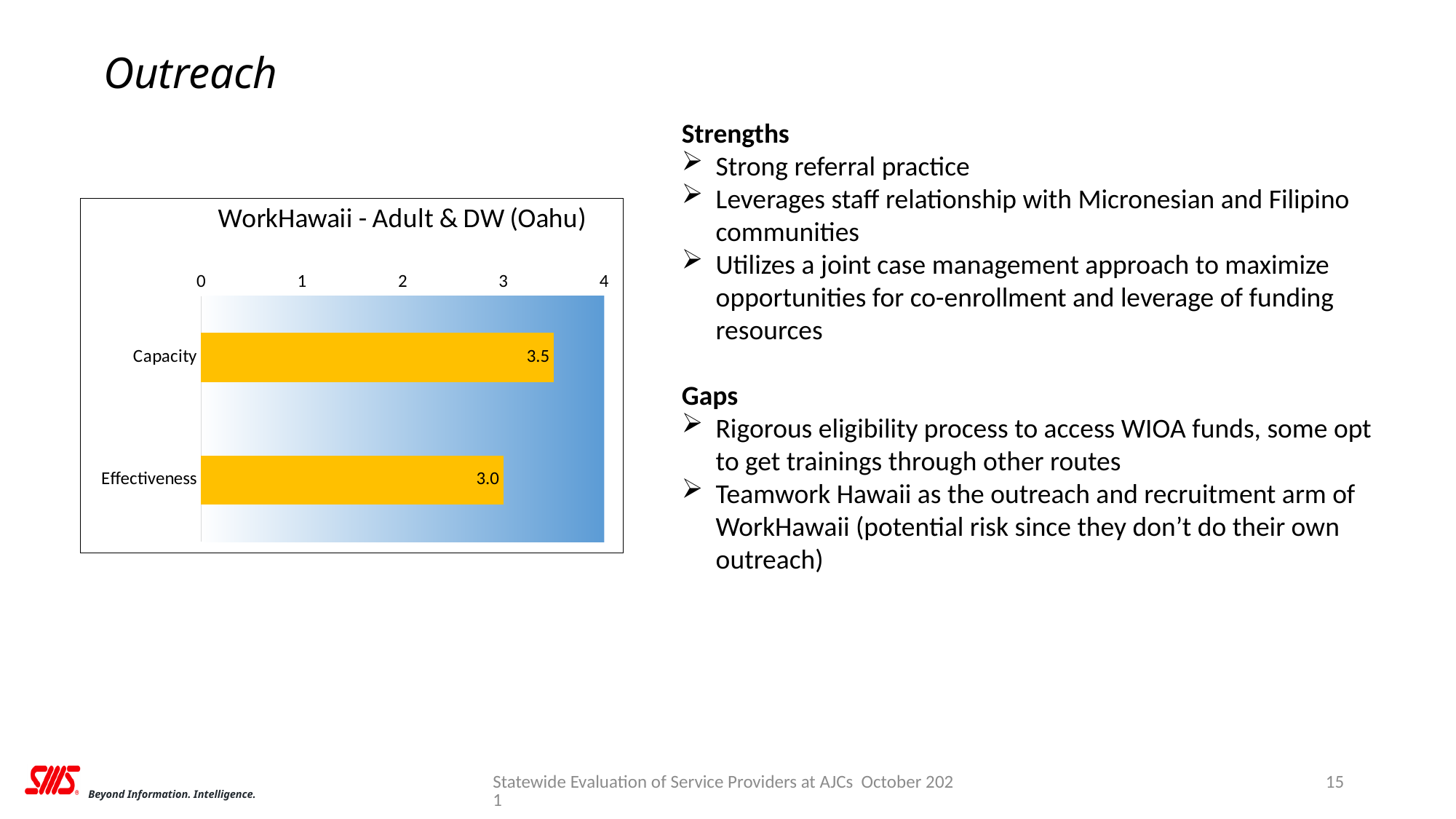
What is the value for Effectiveness in the chart? 3.0 Is the value for Effectiveness greater or less than 4? less What is the value for Capacity in the chart? 3.5 What is the difference between the Capacity and Effectiveness values? 0.5 Which category has the lowest value in the chart? Effectiveness What is the maximum value shown on the chart's axis? 4 Is the value for Capacity greater or less than 3? greater Which is larger, the value for Capacity or the value for Effectiveness? Capacity Which category has the highest value in the chart? Capacity How many categories are shown in the chart? 2 What kind of chart is shown on the slide? Bar chart What is the title of the chart? WorkHawaii - Adult & DW (Oahu)